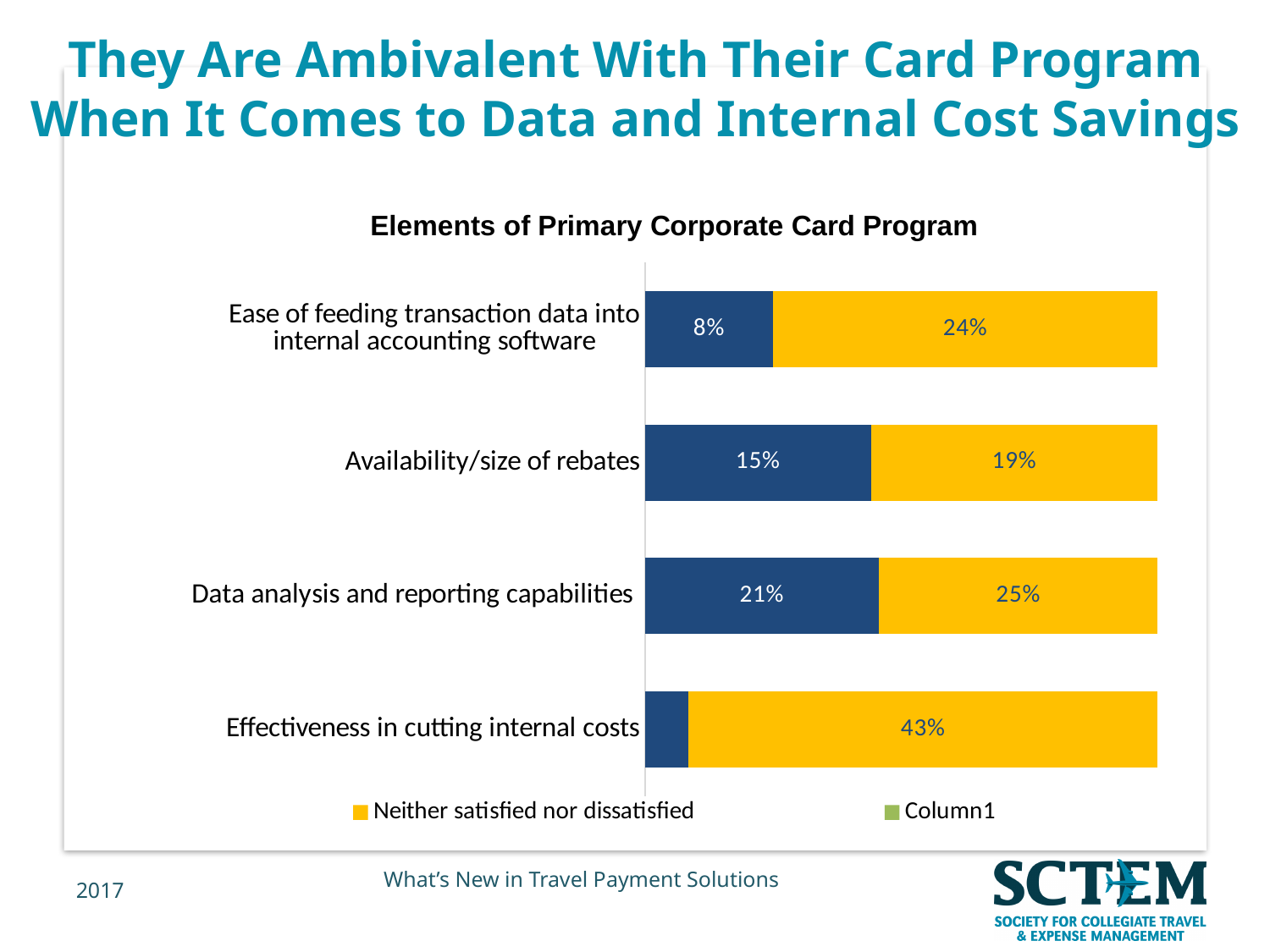
What is the difference between the 'Neither satisfied nor dissatisfied' values for 'Effectiveness in cutting internal costs' and 'Data analysis and reporting capabilities'? 18% How many categories are shown in the chart? 4 What is the 'Neither satisfied nor dissatisfied' value for 'Availability/size of rebates'? 19% What is the 'Neither satisfied nor dissatisfied' value for 'Effectiveness in cutting internal costs'? 43% Which category has the lowest 'Neither satisfied nor dissatisfied' value? Availability/size of rebates What kind of chart is shown on the slide? Stacked bar chart What value is shown on the dark blue segment for 'Data analysis and reporting capabilities'? 21% What value is shown on the dark blue segment for 'Ease of feeding transaction data into internal accounting software'? 8% Which category has the highest 'Neither satisfied nor dissatisfied' value? Effectiveness in cutting internal costs What is the total of the two labelled segments for 'Data analysis and reporting capabilities'? 46% Which is larger: the dark blue segment for 'Availability/size of rebates' or the dark blue segment for 'Data analysis and reporting capabilities'? Data analysis and reporting capabilities What is the title of the chart? Elements of Primary Corporate Card Program